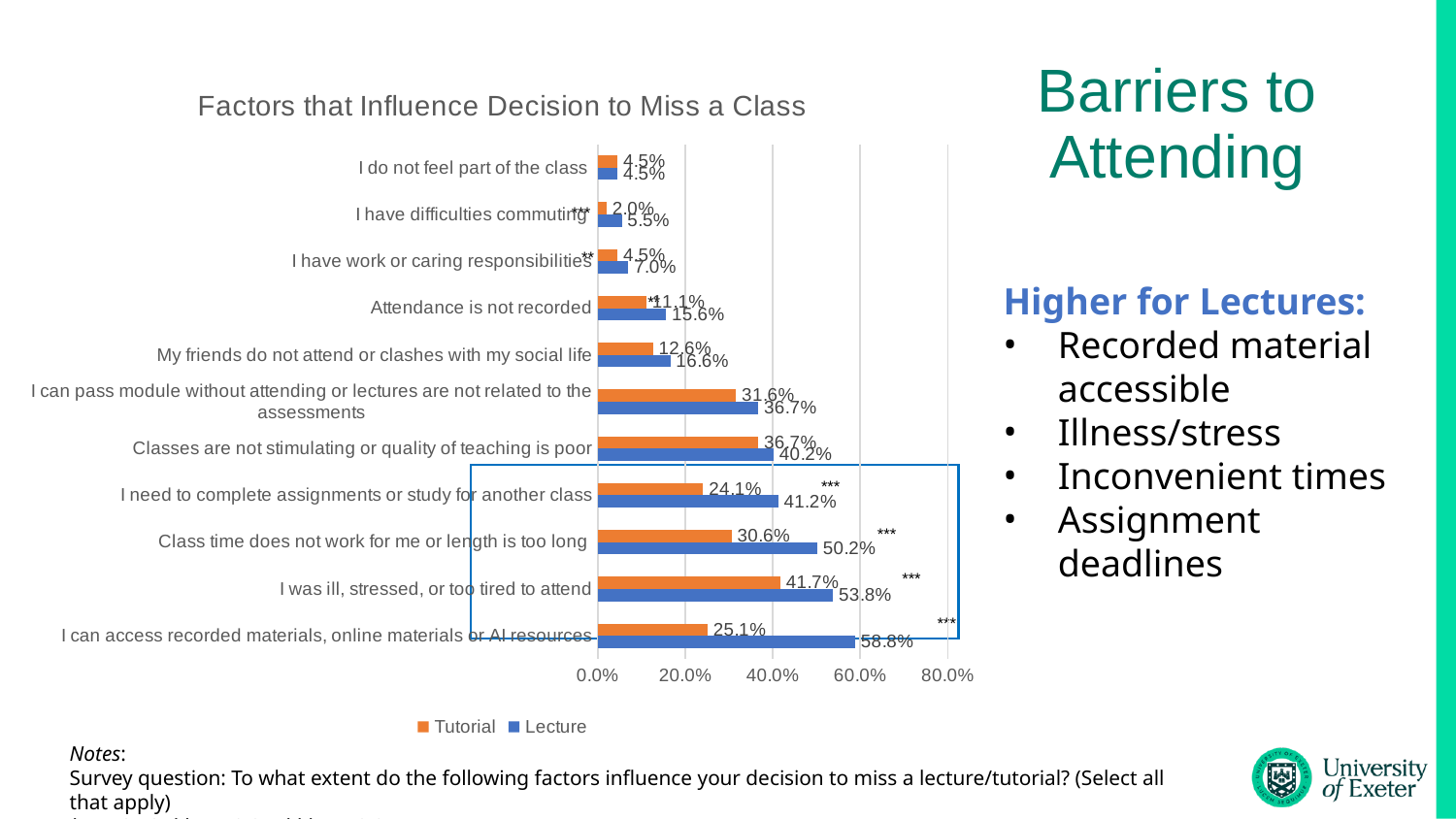
What is the Lecture value for "Class time does not work for me or length is too long"? 50.2% What is the Tutorial value for "I was ill, stressed, or too tired to attend"? 41.7% Which category has the lowest Tutorial value? I have difficulties commuting Which is larger for "Attendance is not recorded": the Tutorial value or the Lecture value? Lecture How many series does the legend list? 2 How many categories are shown on the chart? 11 What kind of chart is shown on the slide? Bar chart Which category has the highest Lecture value? I can access recorded materials, online materials or AI resources What is the difference between the Lecture and Tutorial values for "I can access recorded materials, online materials or AI resources"? 33.7% What is the title of the chart? Factors that Influence Decision to Miss a Class What is the Lecture value for "I can access recorded materials, online materials or AI resources"? 58.8% What is the difference between the Lecture and Tutorial values for "I need to complete assignments or study for another class"? 17.1%